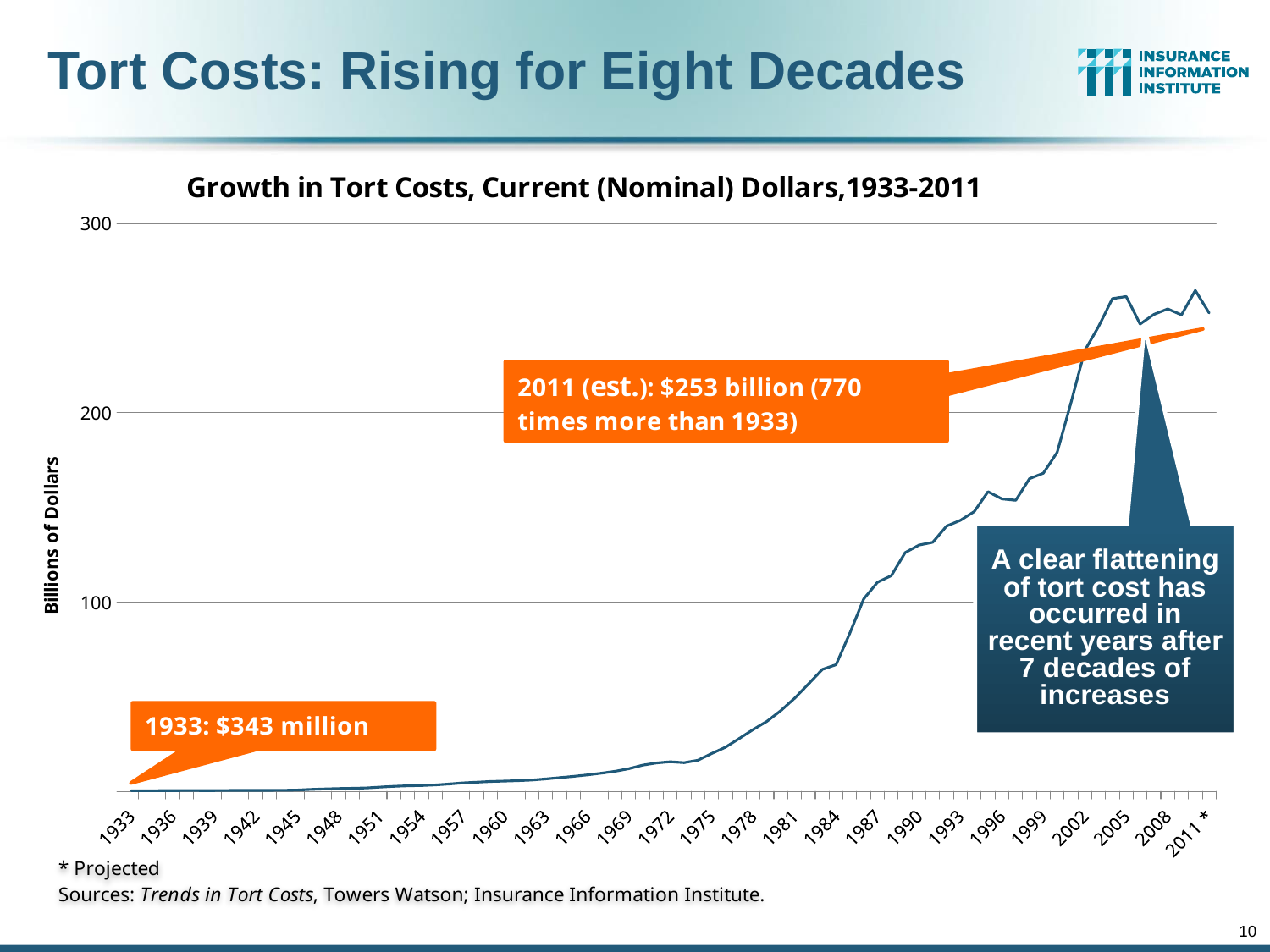
Which year has the lowest tort cost on the chart? 1933 According to the callout on the chart, what were tort costs in 1933? $343 million Is the value for 2005 greater or less than 200? greater What is the label on the vertical axis of the chart? Billions of Dollars According to the callout on the chart, what is the estimated tort cost for 2011? $253 billion Do tort costs generally rise or fall from 1933 to 2011 on the chart? rise Is the value for 1975 greater or less than 100? less What kind of chart is shown on the slide? line chart Is the value for 1984 greater or less than 100? less What is the title of the chart? Growth in Tort Costs, Current (Nominal) Dollars, 1933-2011 Which year has the higher tort cost, 1996 or 2002? 2002